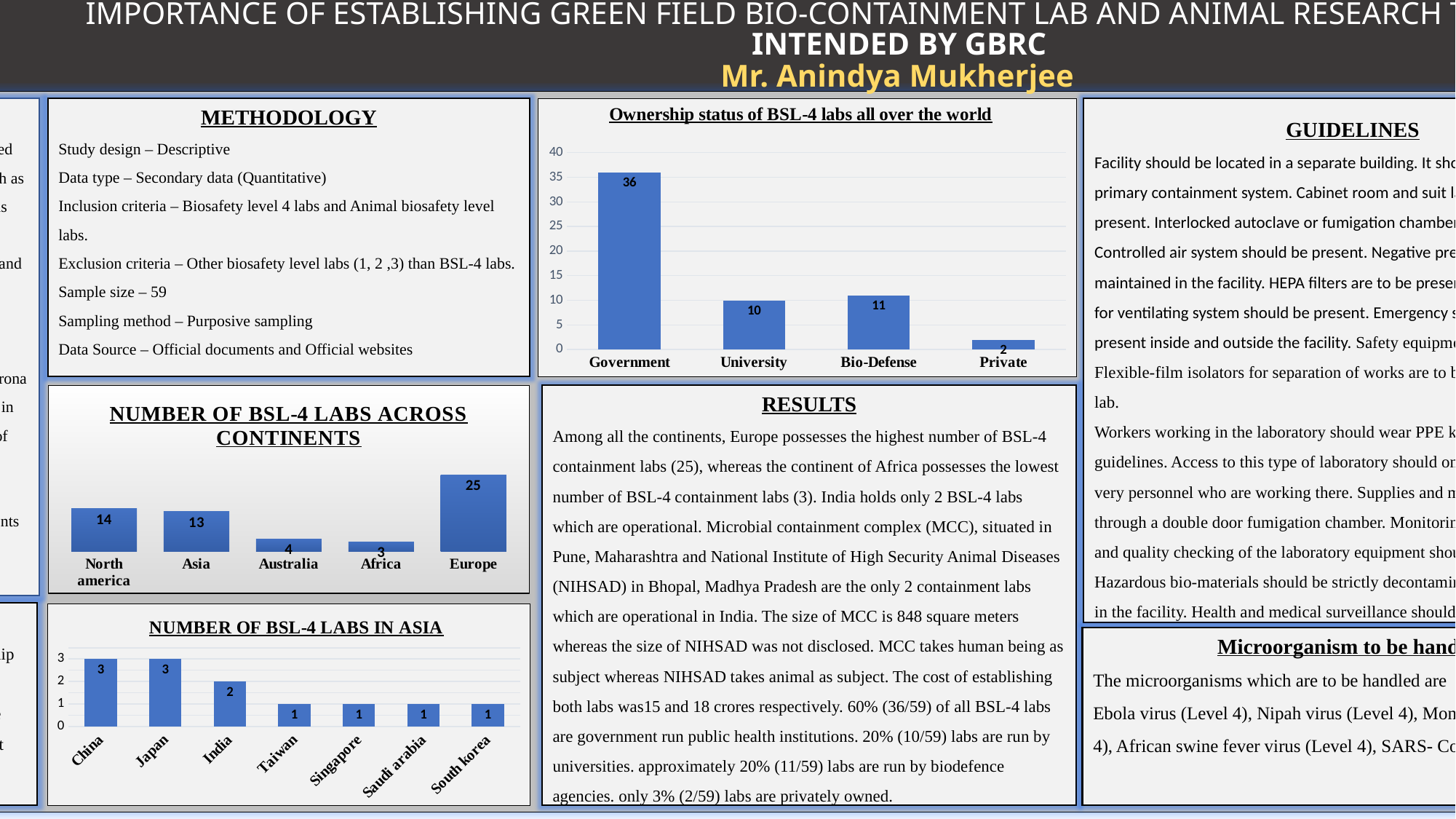
In the 'Ownership status of BSL-4 labs all over the world' chart, what is the difference between Bio-Defense and University? 1 In the 'NUMBER OF BSL-4 LABS ACROSS CONTINENTS' chart, which continent has the lowest value? Africa In the 'NUMBER OF BSL-4 LABS IN ASIA' chart, what is the total of the values for China, Japan and India? 8 In the 'NUMBER OF BSL-4 LABS ACROSS CONTINENTS' chart, which is larger, North america or Asia? North america In the 'Ownership status of BSL-4 labs all over the world' chart, which category has the lowest value? Private In the 'NUMBER OF BSL-4 LABS IN ASIA' chart, what is the value for India? 2 In the 'Ownership status of BSL-4 labs all over the world' chart, how many categories are shown? 4 In the 'NUMBER OF BSL-4 LABS ACROSS CONTINENTS' chart, what is the difference between Europe and Asia? 12 In the 'Ownership status of BSL-4 labs all over the world' chart, what is the value for Government? 36 In the 'NUMBER OF BSL-4 LABS ACROSS CONTINENTS' chart, what is the value for Europe? 25 What type of chart is the 'NUMBER OF BSL-4 LABS IN ASIA' chart? Bar chart In the 'NUMBER OF BSL-4 LABS IN ASIA' chart, how many countries are shown? 7